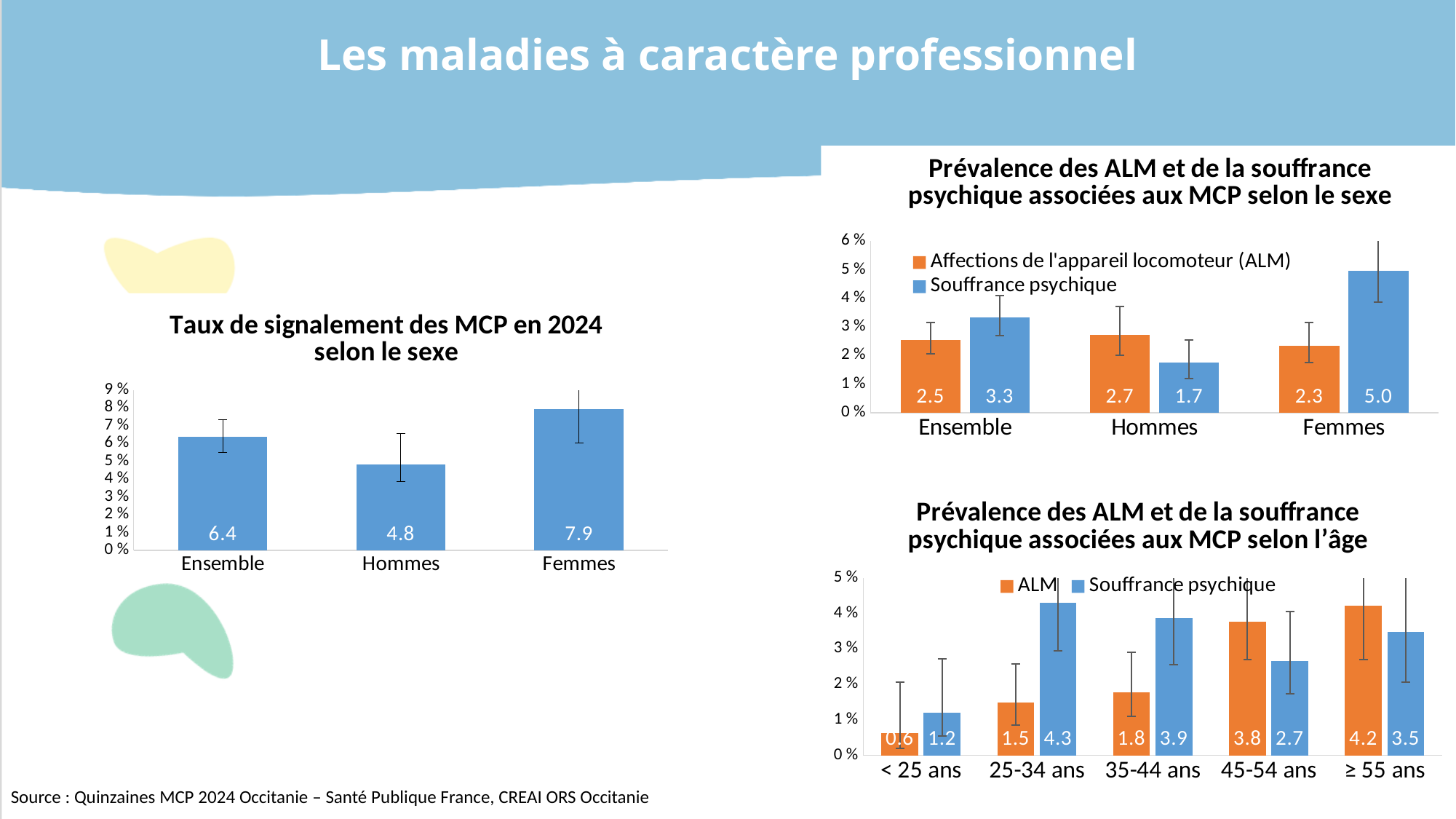
In the chart 'Taux de signalement des MCP en 2024 selon le sexe', what is the value for Femmes? 7.9 In the chart 'Taux de signalement des MCP en 2024 selon le sexe', which category has the lowest value? Hommes In the chart 'Prévalence des ALM et de la souffrance psychique associées aux MCP selon l'âge', what is the Souffrance psychique value for 25-34 ans? 4.3 How many age categories are shown in the chart 'Prévalence des ALM et de la souffrance psychique associées aux MCP selon l'âge'? 5 How many series does the legend list in the chart 'Prévalence des ALM et de la souffrance psychique associées aux MCP selon le sexe'? 2 In the chart 'Taux de signalement des MCP en 2024 selon le sexe', what is the difference between the values for Femmes and Hommes? 3.1 In the chart 'Prévalence des ALM et de la souffrance psychique associées aux MCP selon le sexe', what is the Souffrance psychique value for Femmes? 5.0 What kind of chart is 'Taux de signalement des MCP en 2024 selon le sexe'? Bar chart In the chart 'Prévalence des ALM et de la souffrance psychique associées aux MCP selon le sexe', which is larger for Hommes: ALM or Souffrance psychique? ALM In the chart 'Prévalence des ALM et de la souffrance psychique associées aux MCP selon le sexe', what is the ALM value for Hommes? 2.7 In the chart 'Prévalence des ALM et de la souffrance psychique associées aux MCP selon l'âge', do the ALM values rise or fall as age increases? Rise In the chart 'Prévalence des ALM et de la souffrance psychique associées aux MCP selon l'âge', which age group has the highest ALM value? ≥ 55 ans